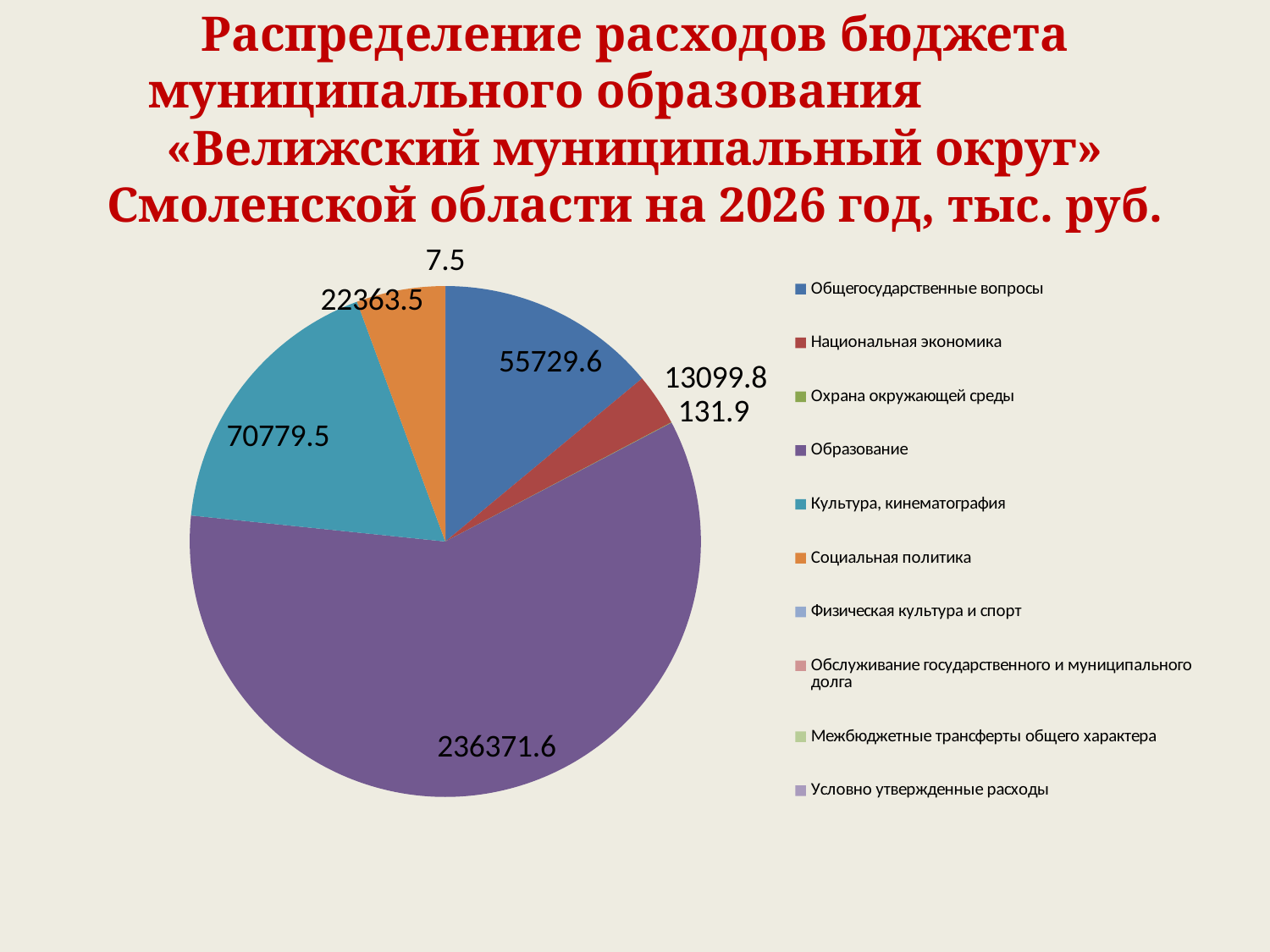
What is the value for Общегосударственные вопросы? 55729.6 What is the value for Культура, кинематография? 70779.5 What colour is the slice for Образование? purple Which is larger, Культура, кинематография or Общегосударственные вопросы? Культура, кинематография What is the value for Социальная политика? 22363.5 What is the value for Образование? 236371.6 What is the difference between the values for Культура, кинематография and Общегосударственные вопросы? 15049.9 What kind of chart is shown on the slide? pie chart Which category has the largest slice of the pie? Образование What is the difference between the values for Социальная политика and Национальная экономика? 9263.7 What is the value for Национальная экономика? 13099.8 How many entries does the legend list? 10